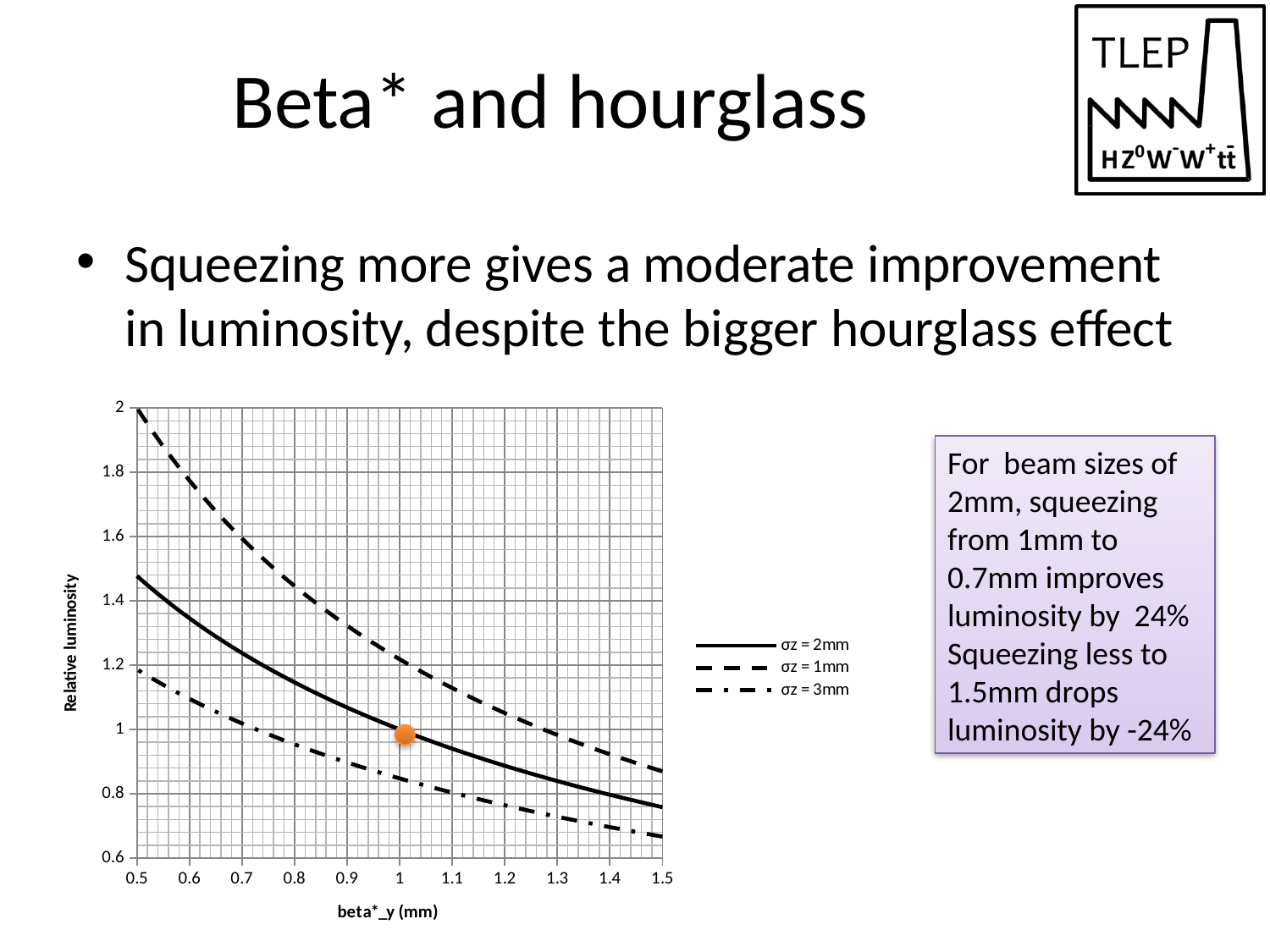
What is the title of the chart's y axis? Relative luminosity Is the relative luminosity for σz = 3mm at beta*_y = 1.5 greater or less than 0.8? less What kind of chart is shown on the slide? line chart How many series does the chart legend list? 3 Which series has the highest relative luminosity at beta*_y = 0.5? σz = 1mm Is the relative luminosity for σz = 3mm at beta*_y = 0.5 greater or less than 1? greater Is the relative luminosity for σz = 2mm at beta*_y = 0.5 greater or less than 1.4? greater What is the title of the chart's x axis? beta*_y (mm) At beta*_y = 1, which series has the larger relative luminosity, σz = 1mm or σz = 3mm? σz = 1mm Does the relative luminosity for σz = 2mm rise or fall as beta*_y increases? fall Which series has the lowest relative luminosity at beta*_y = 1.5? σz = 3mm